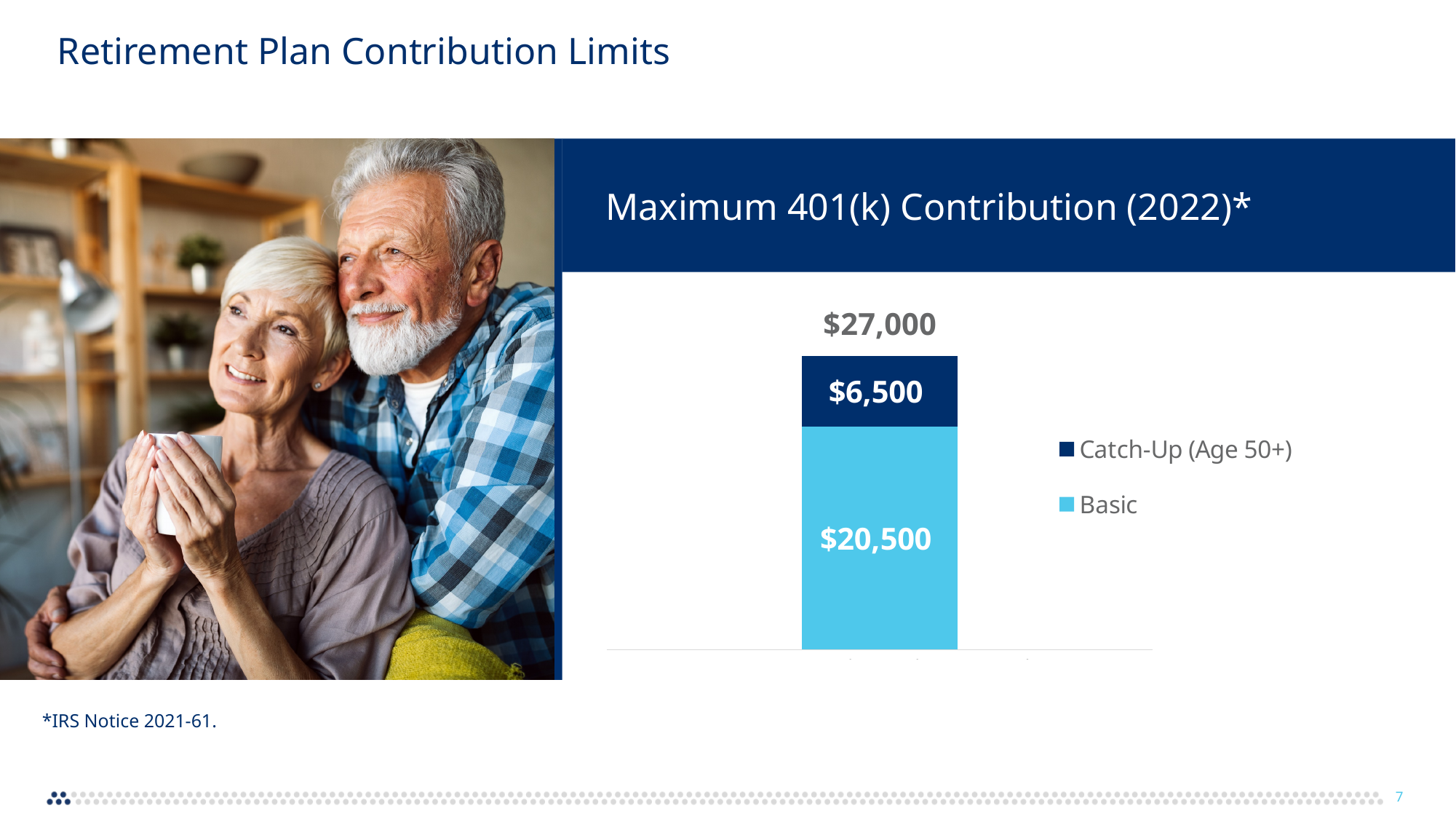
What kind of chart is shown on the slide? Stacked bar chart What is the title of the chart? Maximum 401(k) Contribution (2022)* Which series is shown in dark blue in the legend? Catch-Up (Age 50+) How many series does the legend list? 2 What is the value of the Basic segment in the stacked bar? $20,500 What is the value of the Catch-Up (Age 50+) segment in the stacked bar? $6,500 What is the total of the stacked bar? $27,000 How many bars are plotted in the chart? 1 Which series has the smallest value in the bar? Catch-Up (Age 50+) Which series has the largest value in the bar? Basic What is the difference between the Basic and Catch-Up (Age 50+) segments? $14,000 Which segment is larger, Basic or Catch-Up (Age 50+)? Basic